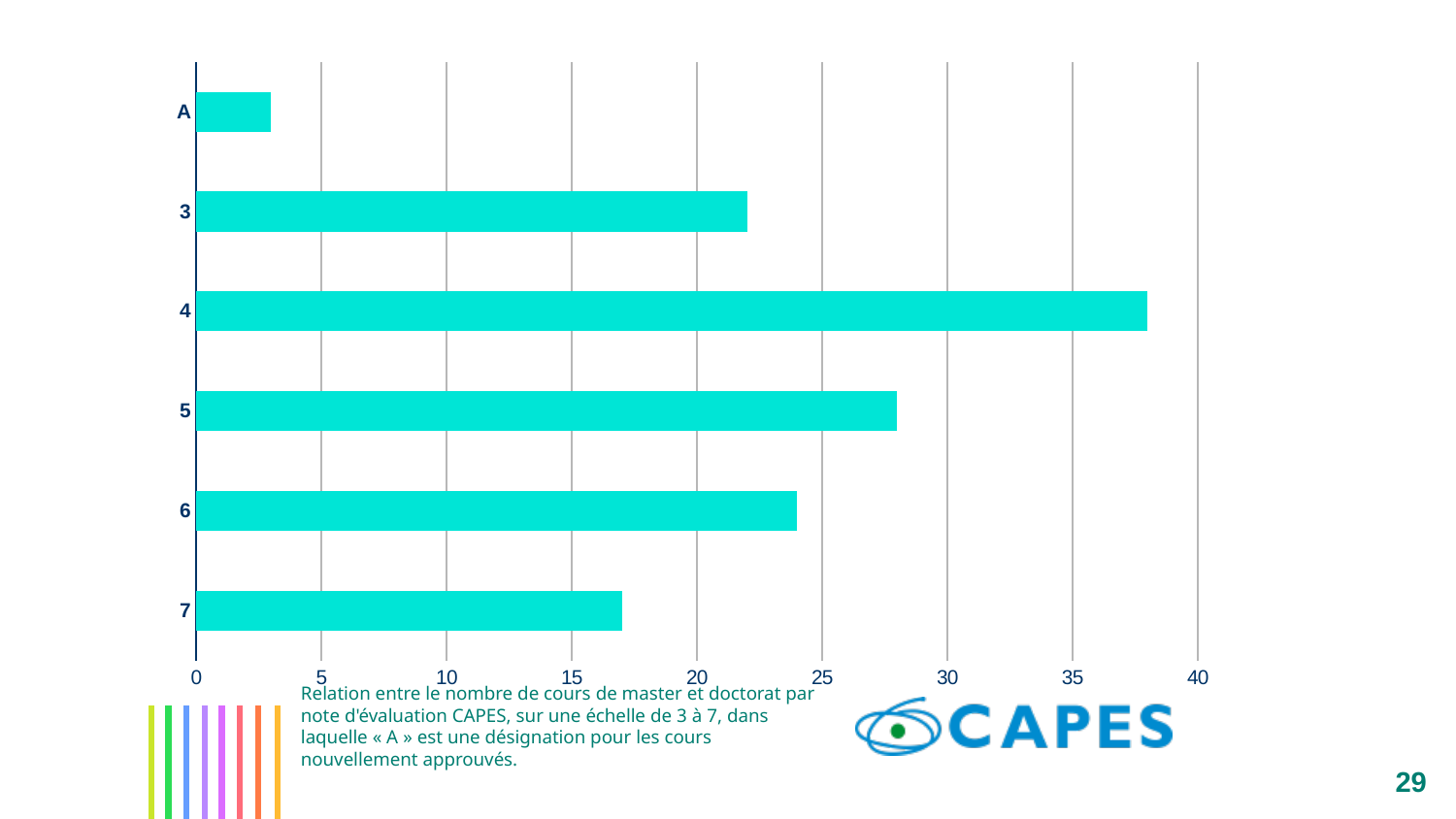
What kind of chart is shown on the slide? Bar chart Is the value for category 6 greater or less than 25? less Is the value for category 4 greater or less than 35? greater Which category has the lowest value? A What is the highest value shown on the horizontal axis? 40 Is the value for category 7 greater or less than 15? greater Which has a larger value, category 3 or category 7? 3 Which category has the highest value? 4 How many categories are plotted on the chart? 6 Which has a larger value, category 5 or category 6? 5